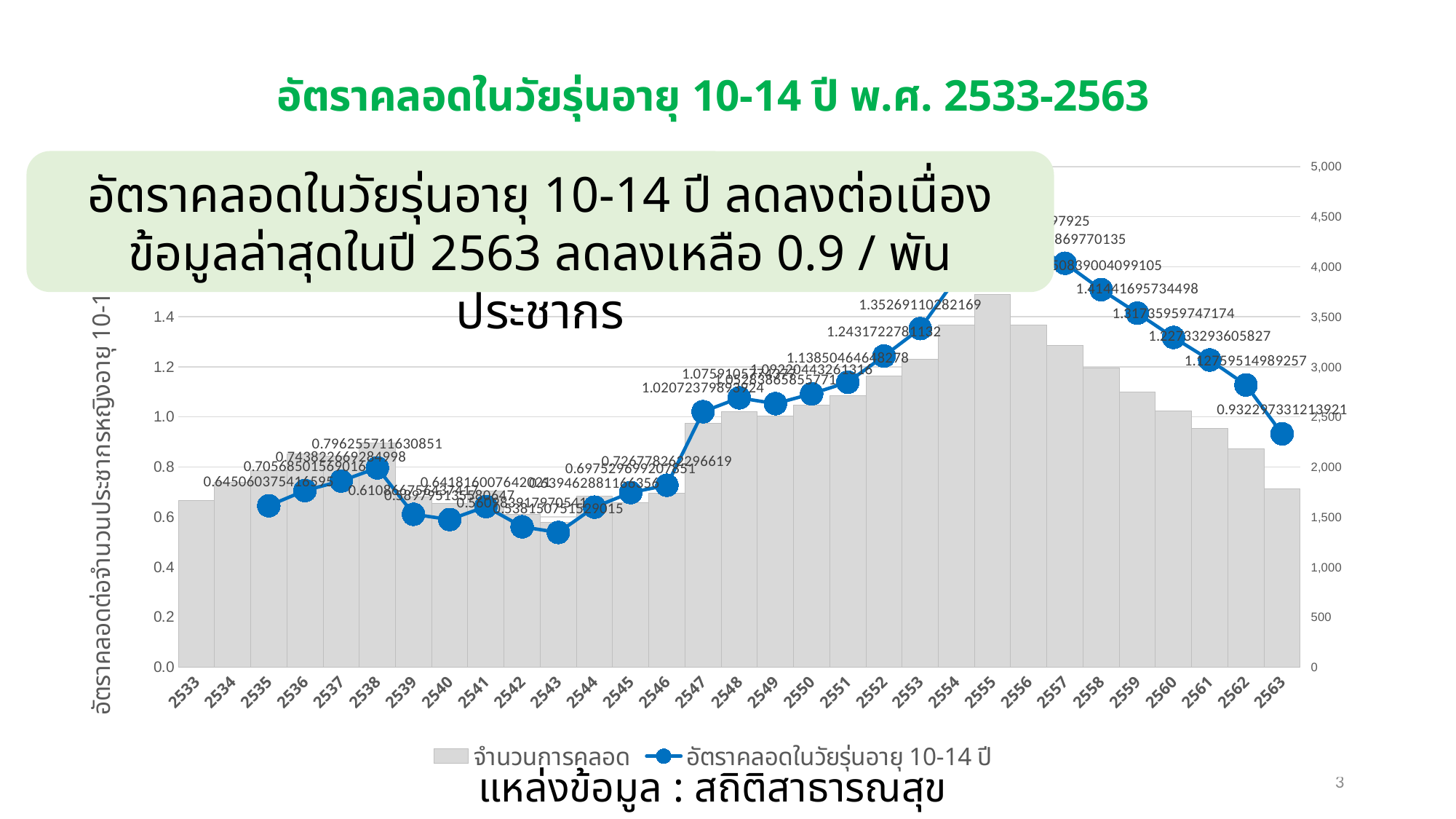
How many series does the legend list? 2 Is the จำนวนการคลอด bar for 2555 greater or less than 3,500? greater How many years are shown on the x axis? 31 Does the อัตราคลอดในวัยรุ่นอายุ 10-14 ปี line rise or fall from 2559 to 2563? fall What is the value of อัตราคลอดในวัยรุ่นอายุ 10-14 ปี for 2563? 0.932297331213921 What kind of chart is this? Combined bar and line chart Is the จำนวนการคลอด bar for 2533 greater or less than 2,000? less What is the value of อัตราคลอดในวัยรุ่นอายุ 10-14 ปี for 2559? 1.41441695734498 What is the value of อัตราคลอดในวัยรุ่นอายุ 10-14 ปี for 2538? 0.796255711630851 What is the value of อัตราคลอดในวัยรุ่นอายุ 10-14 ปี for 2553? 1.35269110282169 Which is larger, the อัตราคลอดในวัยรุ่นอายุ 10-14 ปี value for 2563 or for 2538? 2563 Which year has the highest bar for จำนวนการคลอด? 2555